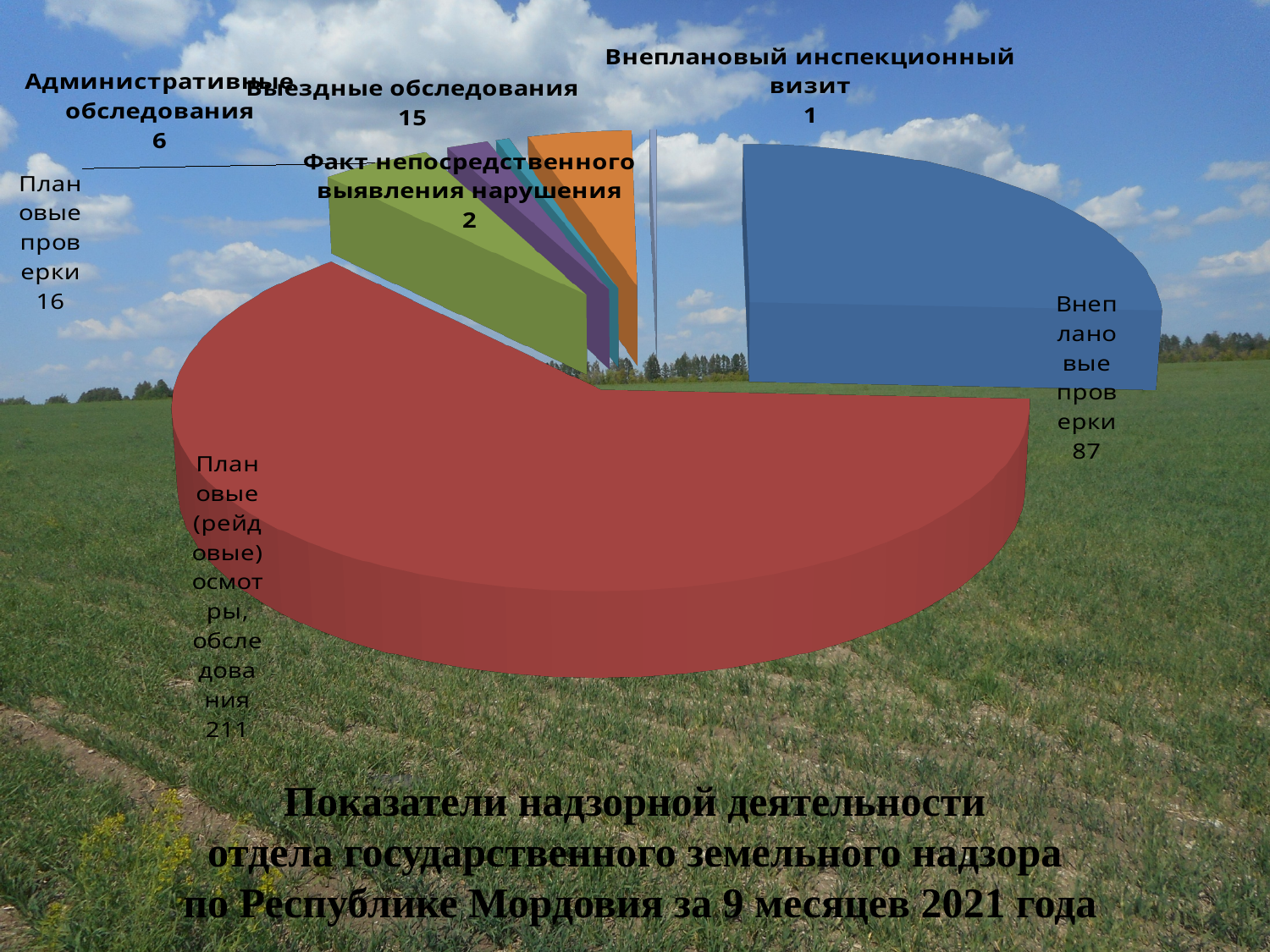
What is the value for Внеплановый инспекционный визит? 1 What type of chart is shown on the slide? Pie chart What is the title of the chart? Показатели надзорной деятельности отдела государственного земельного надзора по Республике Мордовия за 9 месяцев 2021 года What is the difference between Внеплановые проверки and Плановые проверки? 71 What is the value for Плановые проверки? 16 Which category has the largest slice of the pie? Плановые (рейдовые) осмотры, обследования What is the value for Плановые (рейдовые) осмотры, обследования? 211 How many categories does the pie chart show? 7 Which category has the smallest value? Внеплановый инспекционный визит Which is larger, Административные обследования or Выездные обследования? Выездные обследования What is the value for Внеплановые проверки? 87 What is the value for Выездные обследования? 15